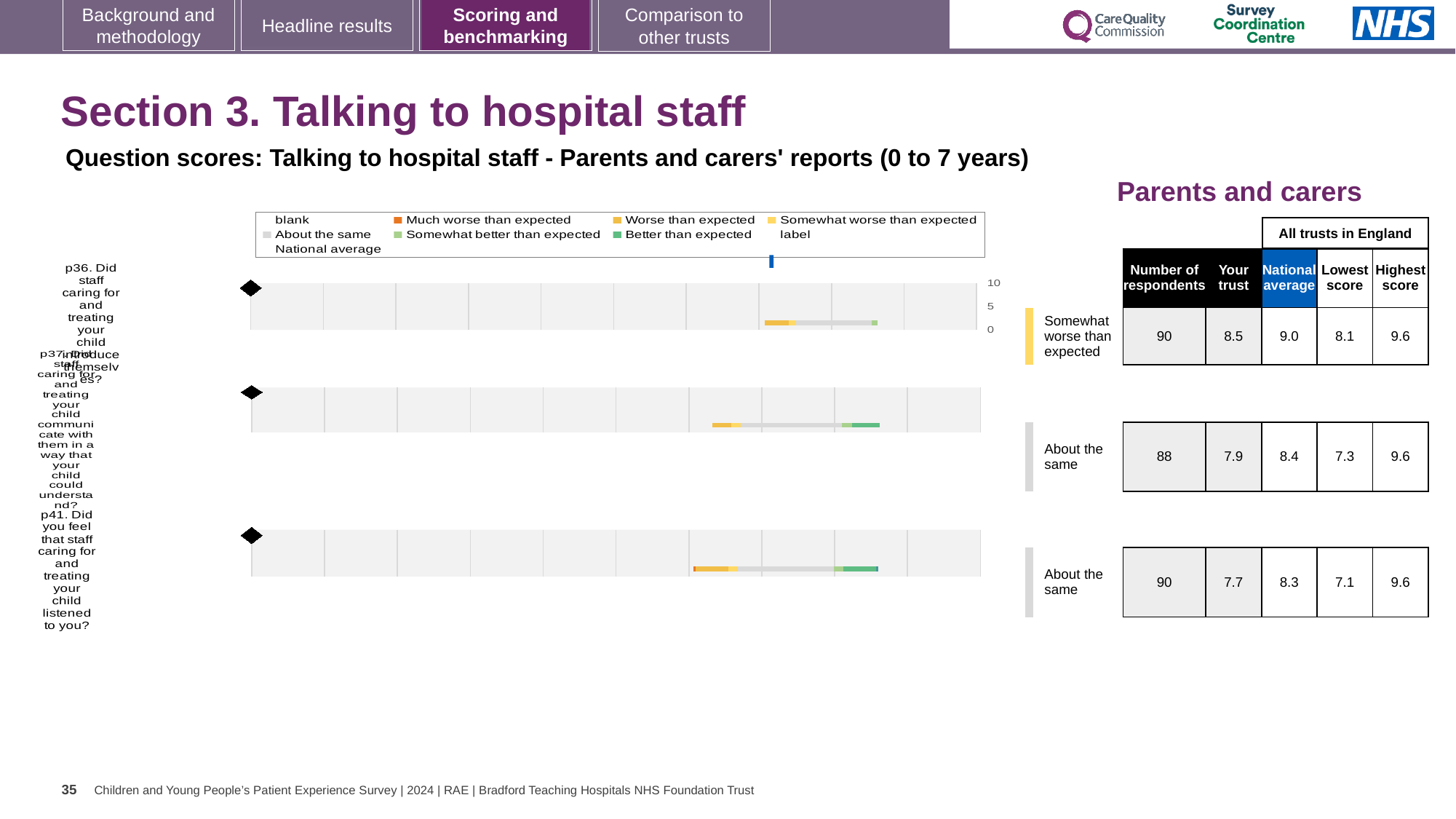
Which legend entry is shown in orange? Much worse than expected What kind of chart is shown on the slide? bar chart In the table to the right of the chart, which question has the lowest 'Your trust' score? p41 In the table to the right of the chart, what is the national average for the second question (p37)? 8.4 In the table to the right of the chart, which question has the highest 'Your trust' score? p36 In the table to the right of the chart, what is the difference between the national average and the 'Your trust' score for p41? 0.6 In the table to the right of the chart, what is the 'Your trust' score for the first question (p36)? 8.5 In the table to the right of the chart, is the 'Your trust' score for p36 larger or smaller than the national average for p36? smaller In the table to the right of the chart, how many respondents answered the second question (p37)? 88 How many question categories (bars) does the chart show? 3 What is the highest tick value shown on the chart's axis? 10 In the table to the right of the chart, what is the 'Your trust' score for the third question (p41)? 7.7